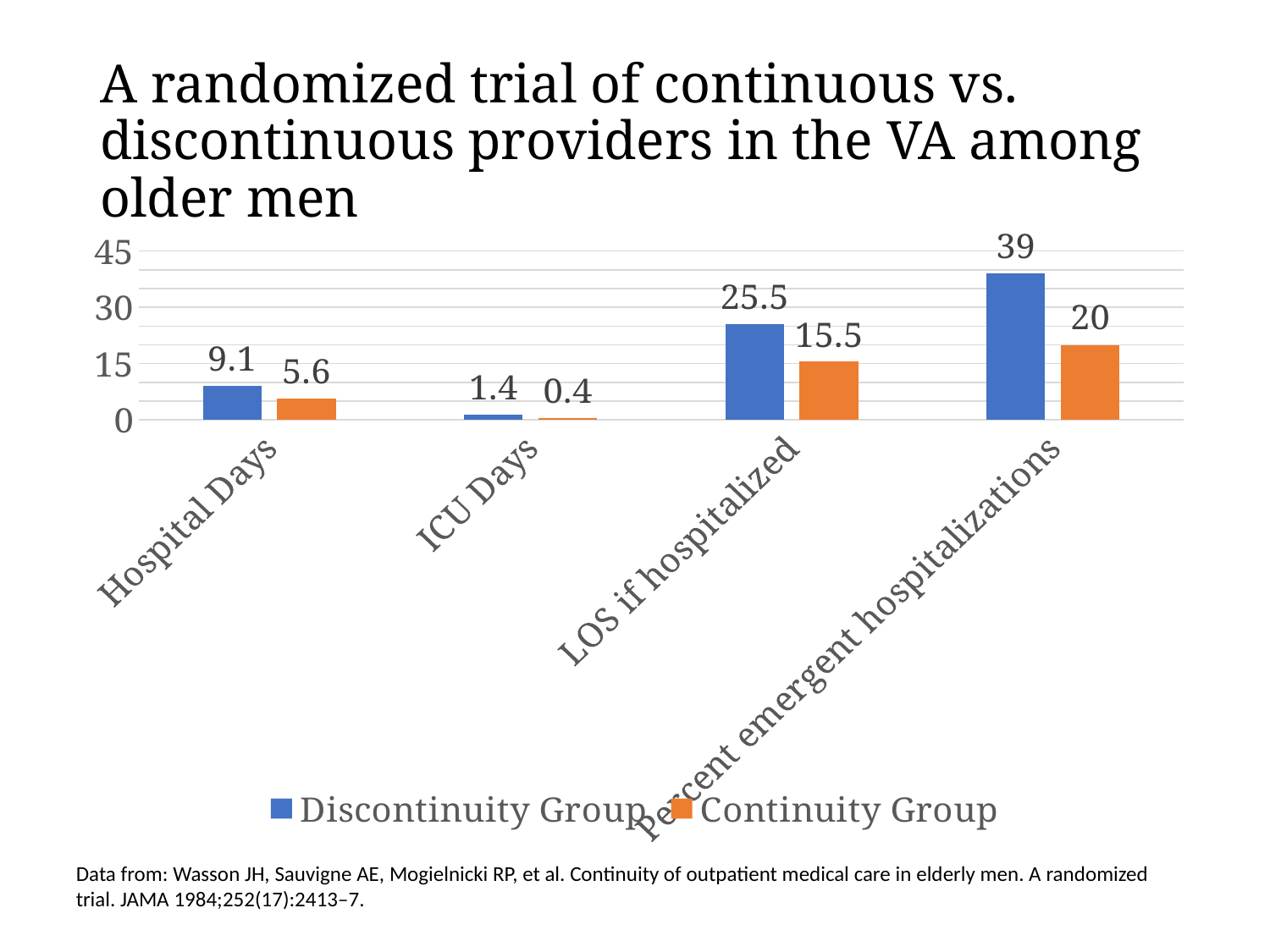
What is the value for the Discontinuity Group for Percent emergent hospitalizations? 39 What is the value for the Continuity Group for ICU Days? 0.4 What is the value for the Discontinuity Group for Hospital Days? 9.1 What is the difference between the Discontinuity Group and Continuity Group values for LOS if hospitalized? 10 How many categories are shown on the x axis? 4 What is the value for the Continuity Group for LOS if hospitalized? 15.5 What kind of chart is shown on the slide? Bar chart How many series does the legend list? 2 What is the difference between the Discontinuity Group and Continuity Group values for Hospital Days? 3.5 Which category has the highest value for the Discontinuity Group? Percent emergent hospitalizations Which group has the larger value for Percent emergent hospitalizations? Discontinuity Group Which category has the lowest value for the Continuity Group? ICU Days